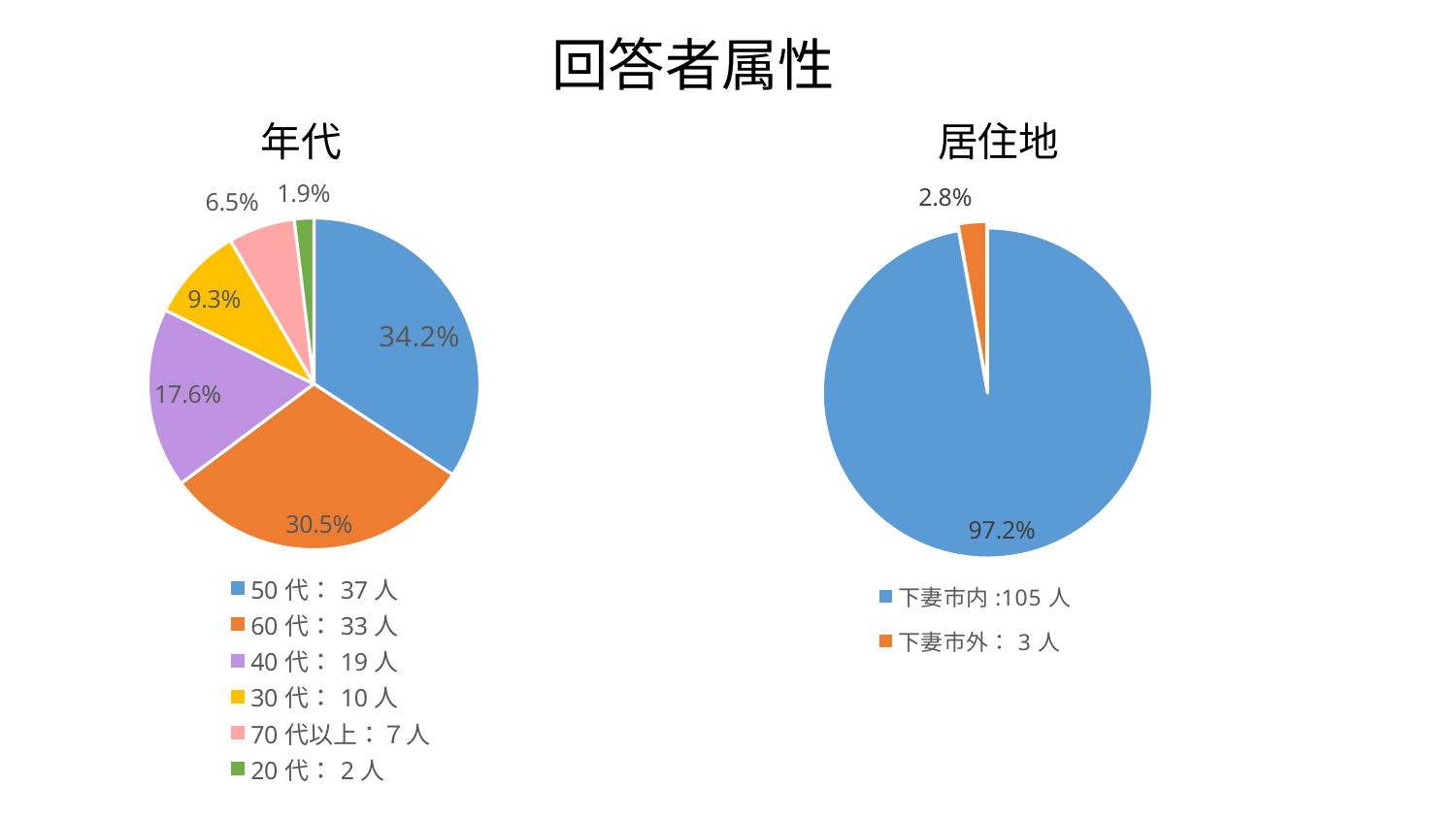
What kind of chart is the 居住地 chart? Pie chart In the 年代 chart, what percentage share does the 40代 slice have? 17.6% In the 年代 chart, how many people does the legend list for 60代? 33 人 In the 年代 chart, what is the difference in percentage points between the 50代 and 60代 slices? 3.7 In the 年代 chart, which age group has the smallest slice? 20代 In the 居住地 chart, how many people does the legend list for 下妻市外? 3 人 In the 居住地 chart, what percentage share does the 下妻市内 slice have? 97.2% In the 年代 chart, which slice is larger, 30代 or 70代以上? 30代 In the 年代 chart, what percentage share does the 50代 slice have? 34.2% In the 年代 chart, which age group has the largest slice? 50代 In the 年代 chart, how many slices does the pie have? 6 What is the title of the chart on the left? 年代